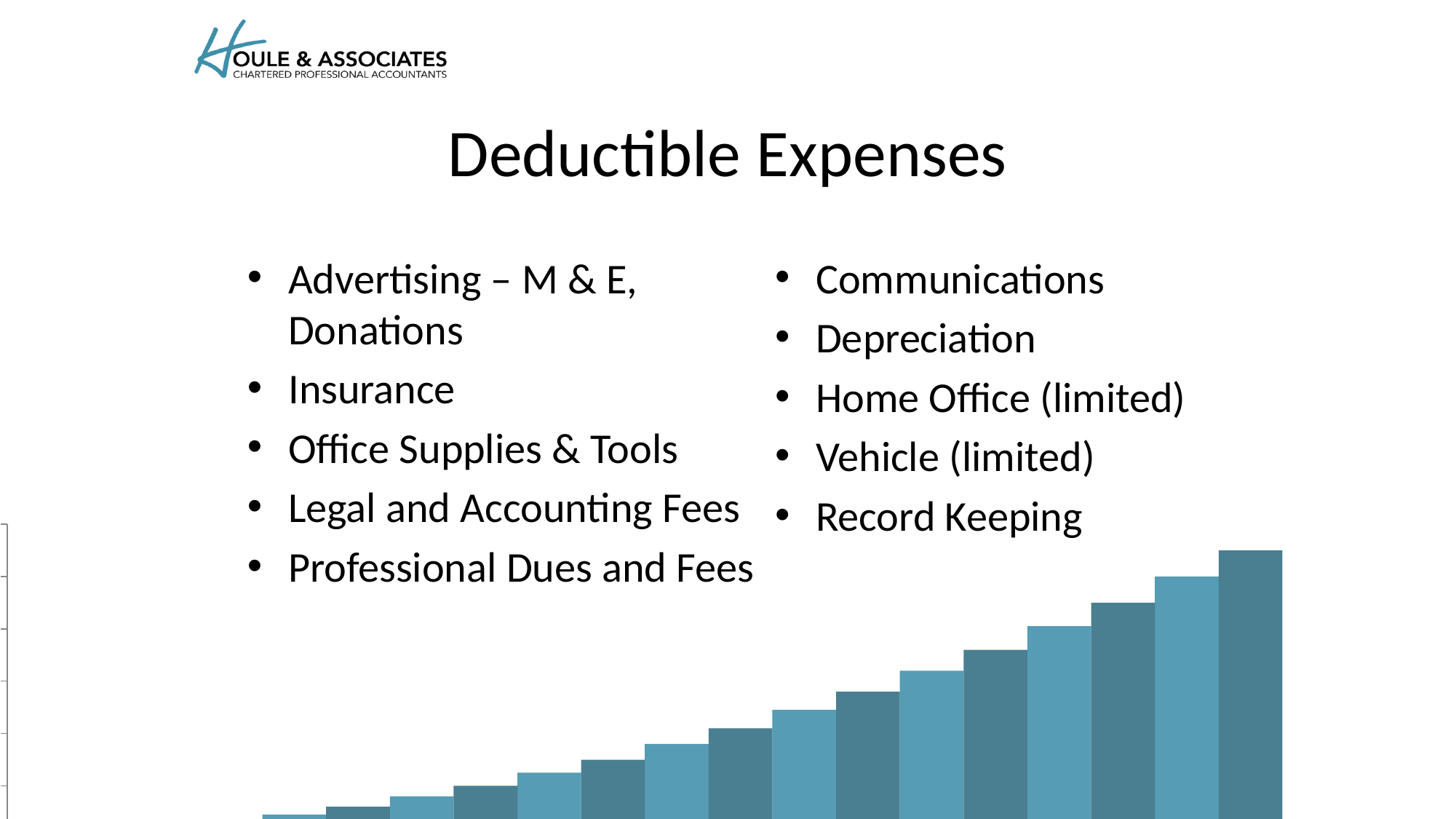
What kind of chart is shown at the bottom of the slide? bar chart Is the tallest bar in the chart at the bottom of the slide on the left or the right side? right Is the shortest bar in the chart at the bottom of the slide on the left or the right side? left Does the chart at the bottom of the slide have any data labels or axis values printed? No Do the bars in the chart at the bottom of the slide rise or fall from left to right? rise